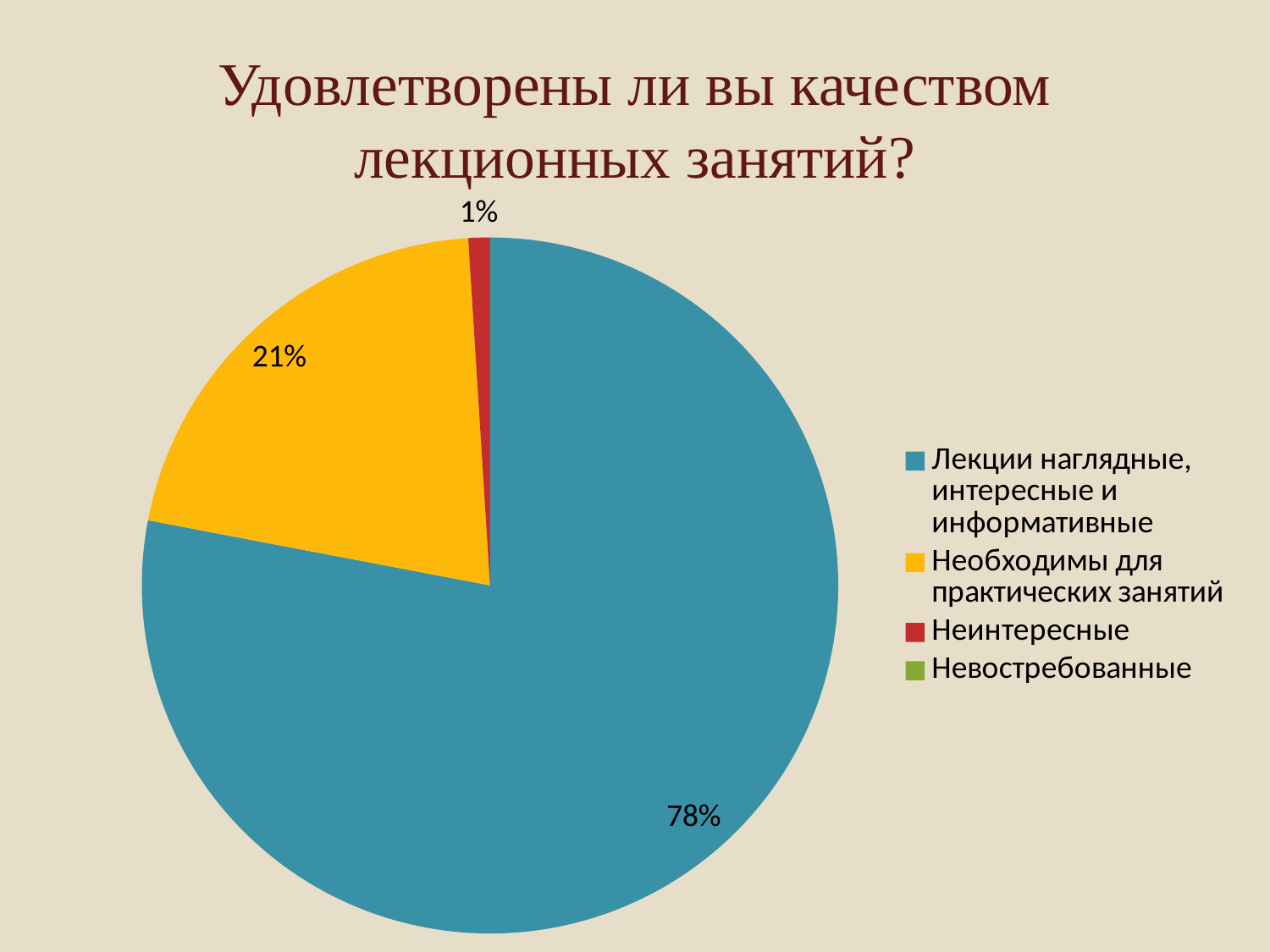
How many entries does the legend list? 4 What is the title of the chart? Удовлетворены ли вы качеством лекционных занятий? Which category has the largest slice of the pie? Лекции наглядные, интересные и информативные What share of the pie is labelled for "Неинтересные"? 1% What share of the pie is labelled for "Лекции наглядные, интересные и информативные"? 78% What kind of chart is shown on the slide? Pie chart What is the sum of the three percentage labels shown on the pie? 100% What is the difference in percentage points between the "Лекции наглядные, интересные и информативные" slice and the "Необходимы для практических занятий" slice? 57 percentage points What colour is the "Неинтересные" slice? Red What share of the pie is labelled for "Необходимы для практических занятий"? 21% Which slice is larger: "Необходимы для практических занятий" or "Неинтересные"? Необходимы для практических занятий